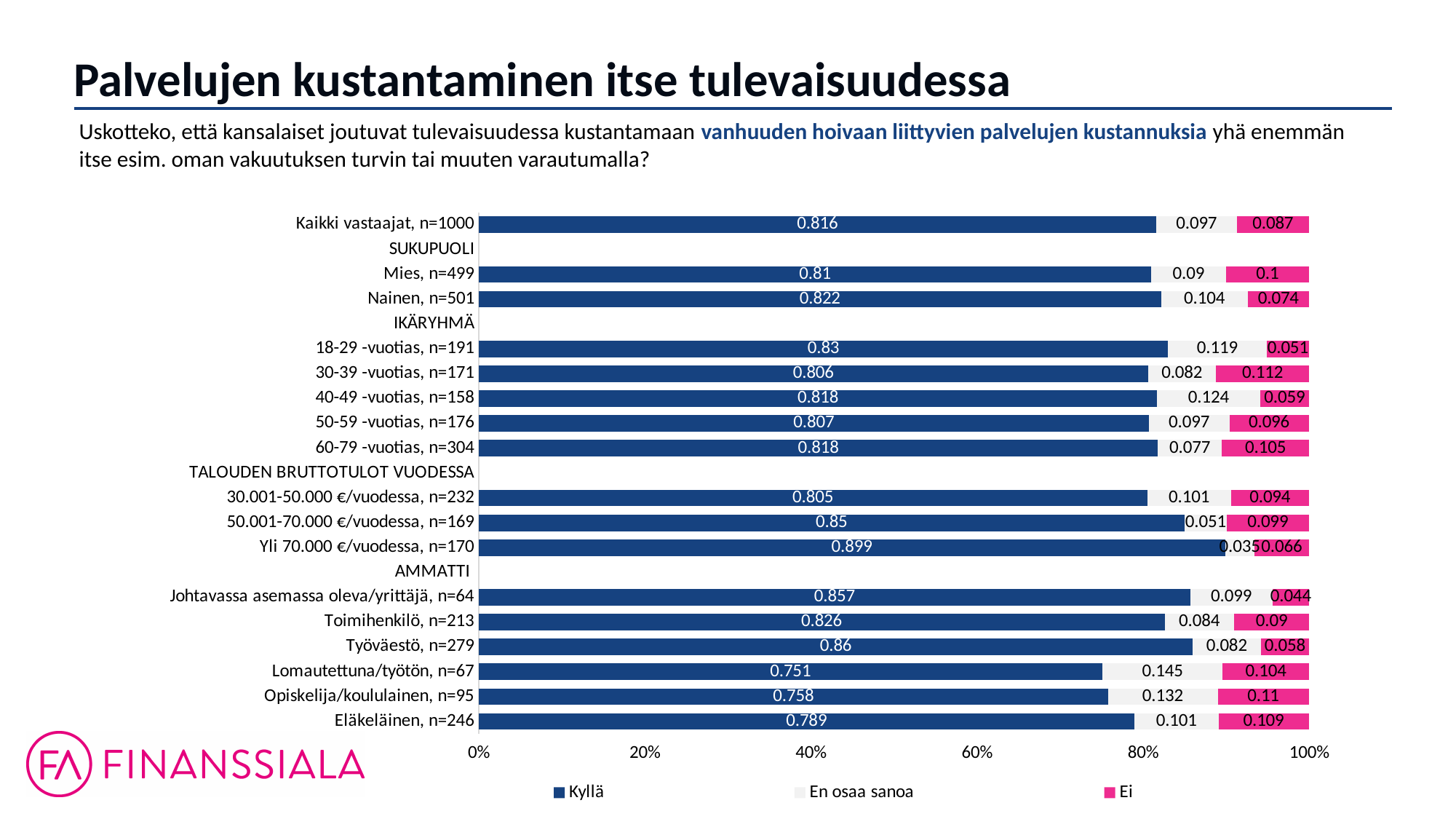
Which category has the highest Kyllä value? Yli 70.000 €/vuodessa, n=170 Which category has the lowest Kyllä value? Lomautettuna/työtön, n=67 What is the Ei value for Mies, n=499? 0.1 Which has a larger Ei value: 30-39 -vuotias, n=171 or 18-29 -vuotias, n=191? 30-39 -vuotias, n=171 What is the En osaa sanoa value for Lomautettuna/työtön, n=67? 0.145 What kind of chart is shown on the slide? Stacked bar chart How many series does the legend list? 3 What is the Kyllä value for Kaikki vastaajat, n=1000? 0.816 What is the difference between the Kyllä values for Nainen, n=501 and Mies, n=499? 0.012 Which category has the highest En osaa sanoa value? Lomautettuna/työtön, n=67 How many age-group (IKÄRYHMÄ) categories are plotted? 5 What colour represents the Ei series in the legend? Pink